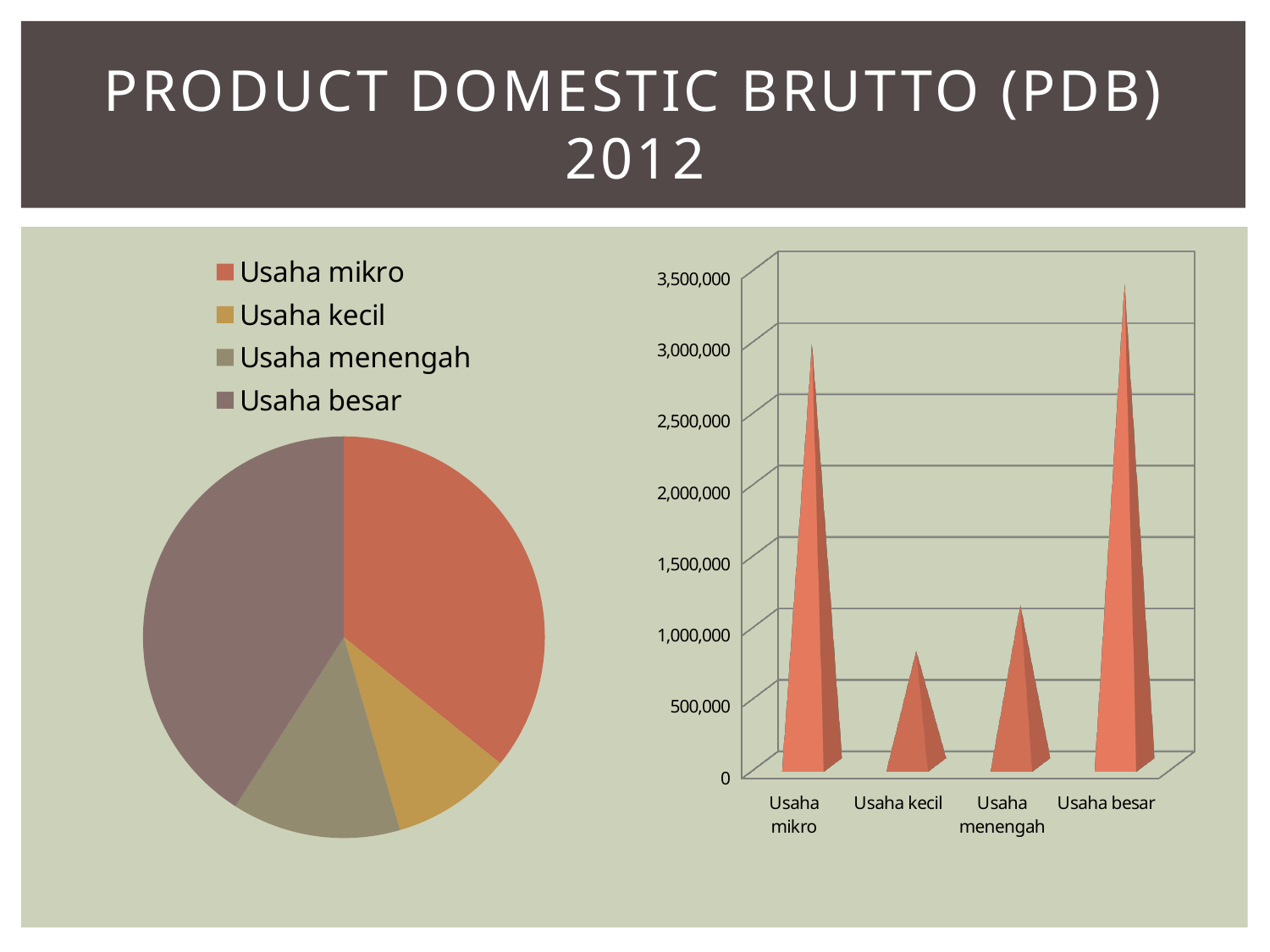
In the bar chart on the right, is the value for Usaha besar greater or less than 3,000,000? greater In the bar chart on the right, is the value for Usaha kecil greater or less than 1,000,000? less In the bar chart on the right, how many categories are shown on the x axis? 4 What kind of chart is on the left side of the slide? pie chart In the bar chart on the right, which category has the lowest value? Usaha kecil In the bar chart on the right, which category has the highest value? Usaha besar In the bar chart on the right, which is larger, the value for Usaha menengah or the value for Usaha kecil? Usaha menengah In the bar chart on the right, is the value for Usaha menengah greater or less than 1,000,000? greater What kind of chart is on the right side of the slide? bar chart How many entries does the legend of the pie chart on the left list? 4 In the pie chart on the left, which category has the largest slice? Usaha besar